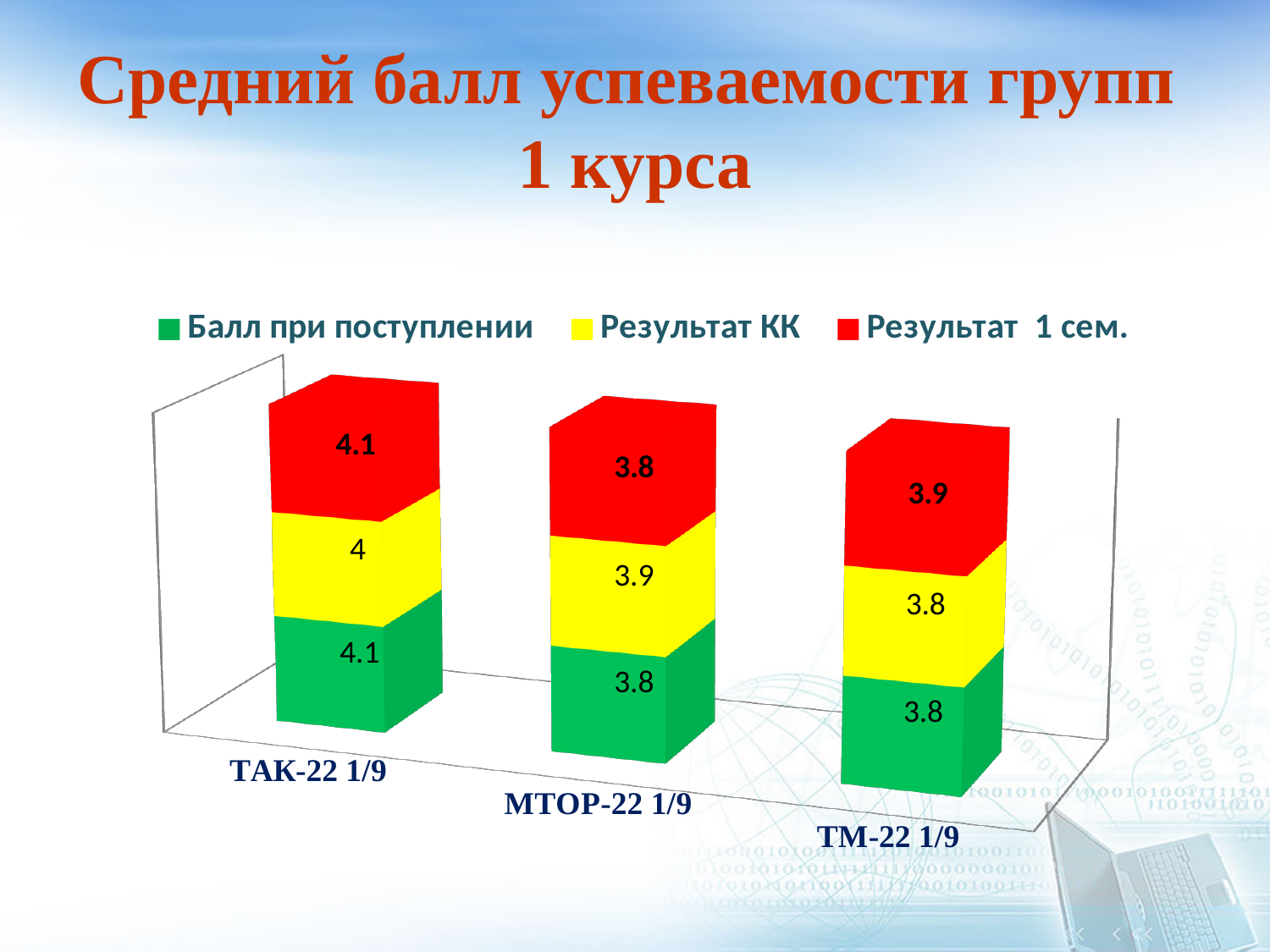
What is the total of the stacked bar for ТАК-22 1/9? 12.2 What is the value of Результат КК for МТОР-22 1/9? 3.9 What is the difference between Результат 1 сем. for ТАК-22 1/9 and for МТОР-22 1/9? 0.3 What is the value of Результат 1 сем. for ТМ-22 1/9? 3.9 Which is larger: Балл при поступлении for ТАК-22 1/9 or for ТМ-22 1/9? ТАК-22 1/9 What is the value of Результат КК for ТАК-22 1/9? 4 How many groups are shown on the x axis? 3 Which group has the highest value for Результат 1 сем.? ТАК-22 1/9 What is the value of Балл при поступлении for ТАК-22 1/9? 4.1 Which group has the lowest value for Результат КК? ТМ-22 1/9 How many series does the legend list? 3 What kind of chart is shown on the slide? Stacked bar chart